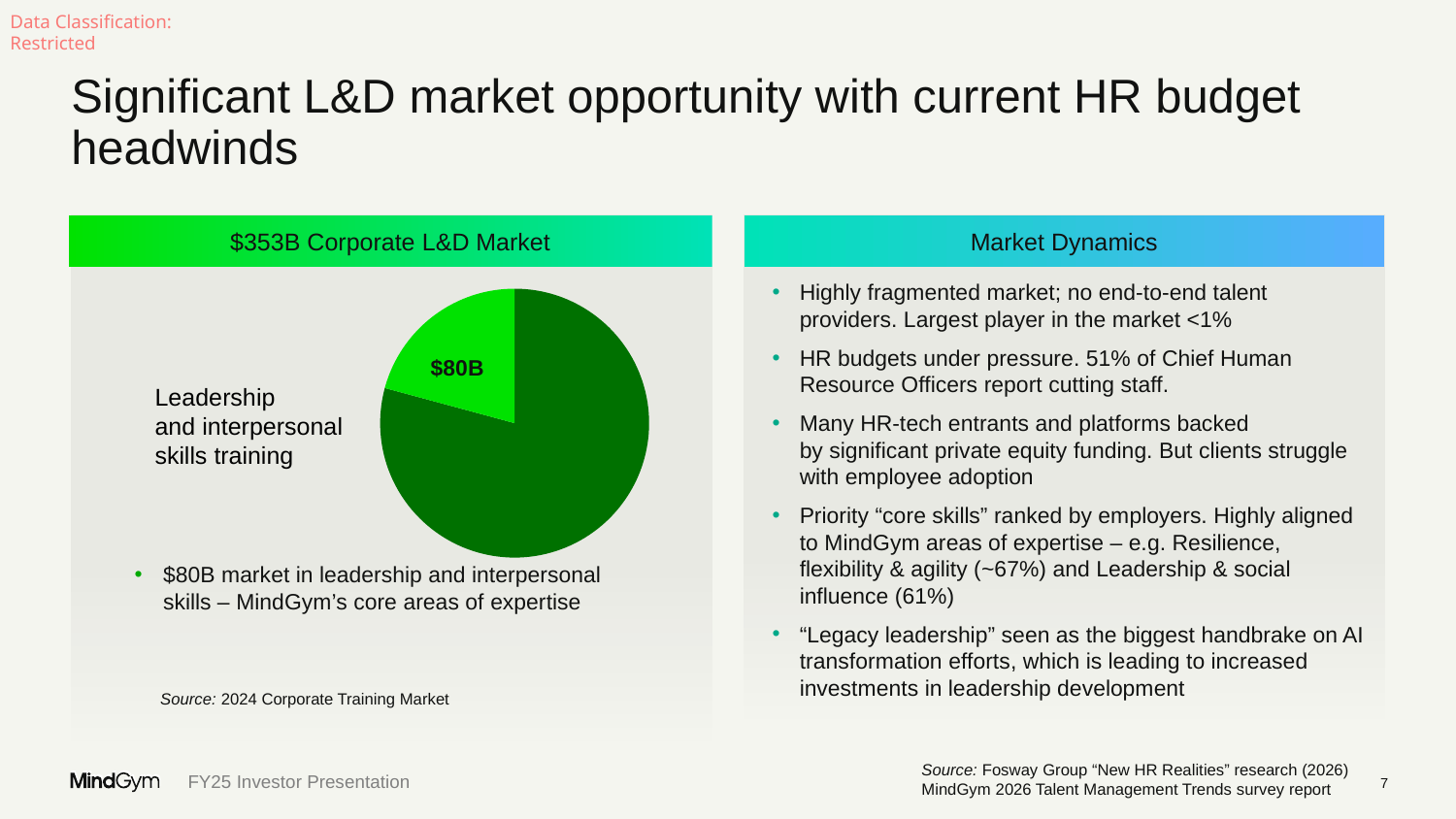
How many slices does the pie chart have? 2 What is the title of the chart panel on the left of the slide? $353B Corporate L&D Market What kind of chart is shown under the "$353B Corporate L&D Market" heading? Pie chart Which slice of the pie chart is larger: the leadership and interpersonal skills training slice or the remaining slice? The remaining slice What is the total size of the corporate L&D market given in the chart heading? $353B What colour is the $80B slice in the pie chart? Light green What is the size of the leadership and interpersonal skills training market shown in the pie chart? $80B What value is printed on the labelled slice of the pie chart? $80B Is the leadership and interpersonal skills training slice the smaller slice of the pie chart? Yes Based on the $353B total and the $80B leadership slice, how large is the rest of the corporate L&D market? $273B